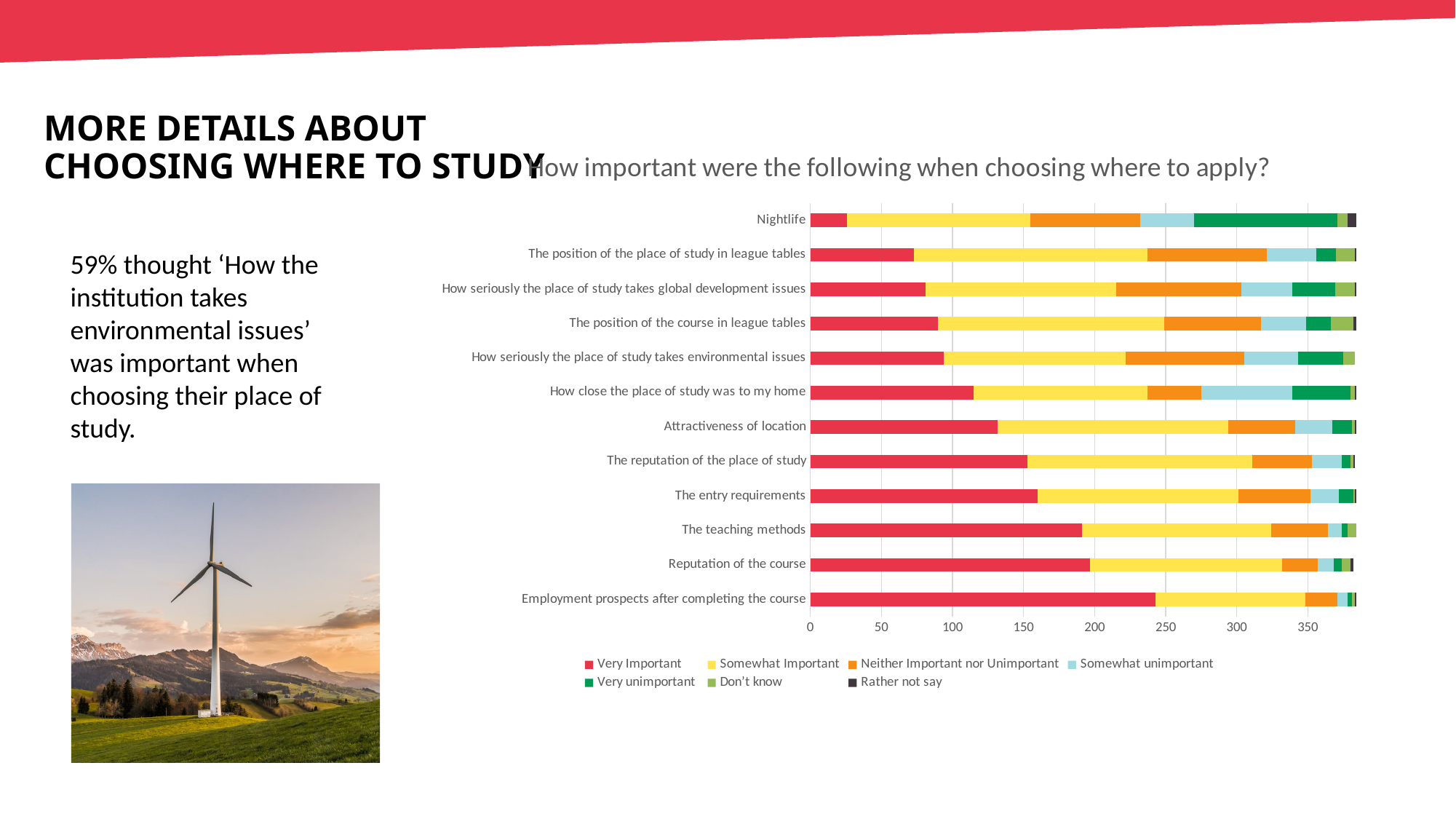
Is the 'Very Important' value for Attractiveness of location greater or less than 150? less Which category has the longest 'Very unimportant' segment? Nightlife Is the 'Very Important' value for Employment prospects after completing the course greater or less than 200? greater How many series does the chart legend list? 7 Moving from Nightlife at the top to Employment prospects at the bottom, does the 'Very Important' segment get longer or shorter? longer Which category has the shortest 'Very Important' segment? Nightlife What kind of chart is shown on the slide? Stacked bar chart Which has a larger 'Very Important' value: Nightlife or The entry requirements? The entry requirements How many categories (factors) are listed on the chart? 12 Which category has the longest 'Very Important' segment? Employment prospects after completing the course What is the title of the chart? How important were the following when choosing where to apply? Is the 'Very Important' value for Nightlife greater or less than 50? less